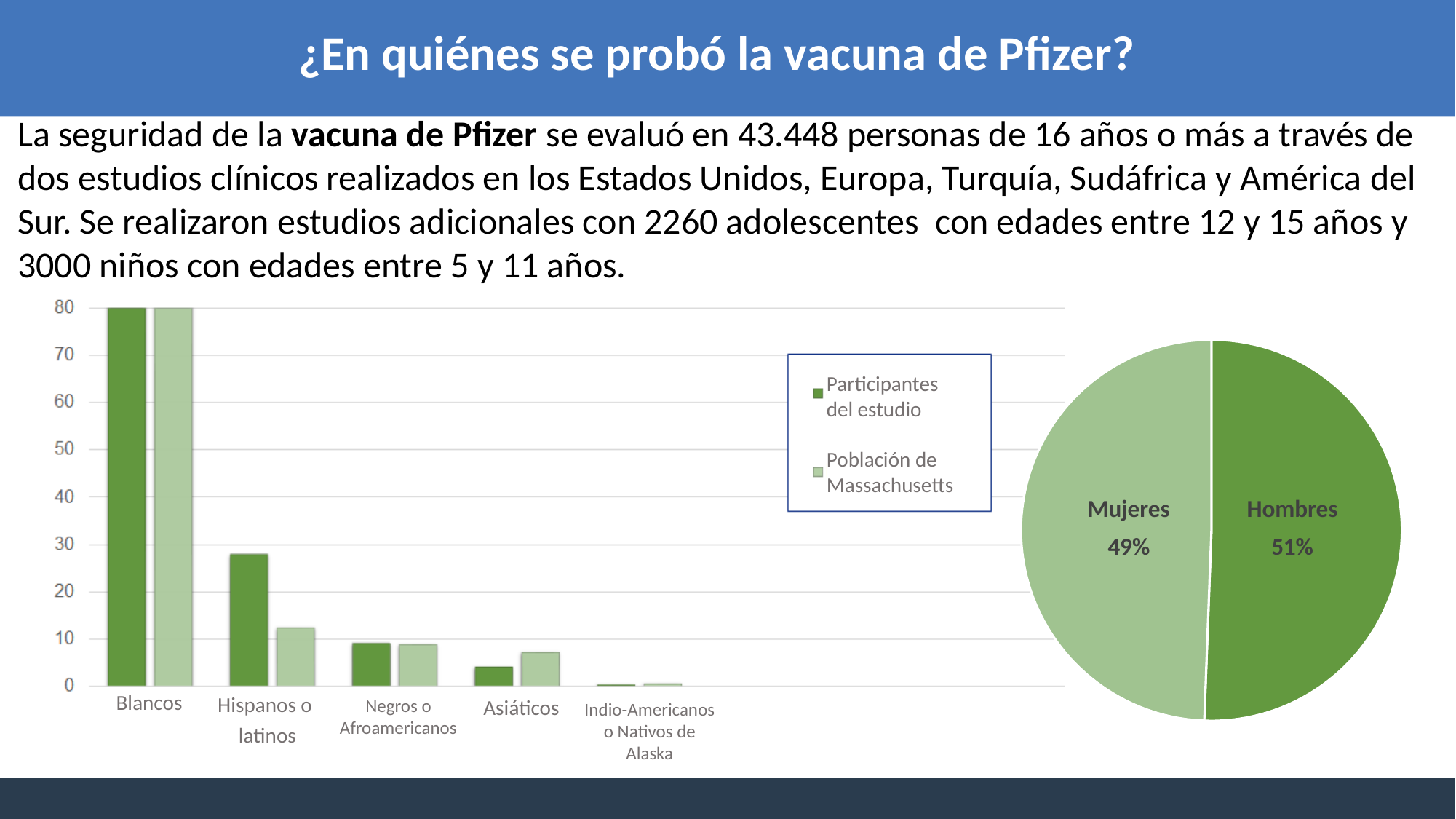
How many categories are shown on the x axis of the bar chart on the left? 5 In the pie chart on the right, what share is shown for Hombres? 51% In the pie chart on the right, what share is shown for Mujeres? 49% In the bar chart on the left, is the Participantes del estudio value for Hispanos o latinos greater or less than 20? greater What kind of chart is the chart on the left of the slide? Bar chart How many slices does the pie chart on the right have? 2 In the bar chart on the left, which category has the lowest value for Participantes del estudio? Indio-Americanos o Nativos de Alaska How many series does the legend of the bar chart on the left list? 2 In the pie chart on the right, which slice is larger, Mujeres or Hombres? Hombres In the bar chart on the left, which category has the highest value for Participantes del estudio? Blancos What kind of chart is the chart on the right of the slide? Pie chart In the bar chart on the left, for Hispanos o latinos, which series has the larger value, Participantes del estudio or Población de Massachusetts? Participantes del estudio